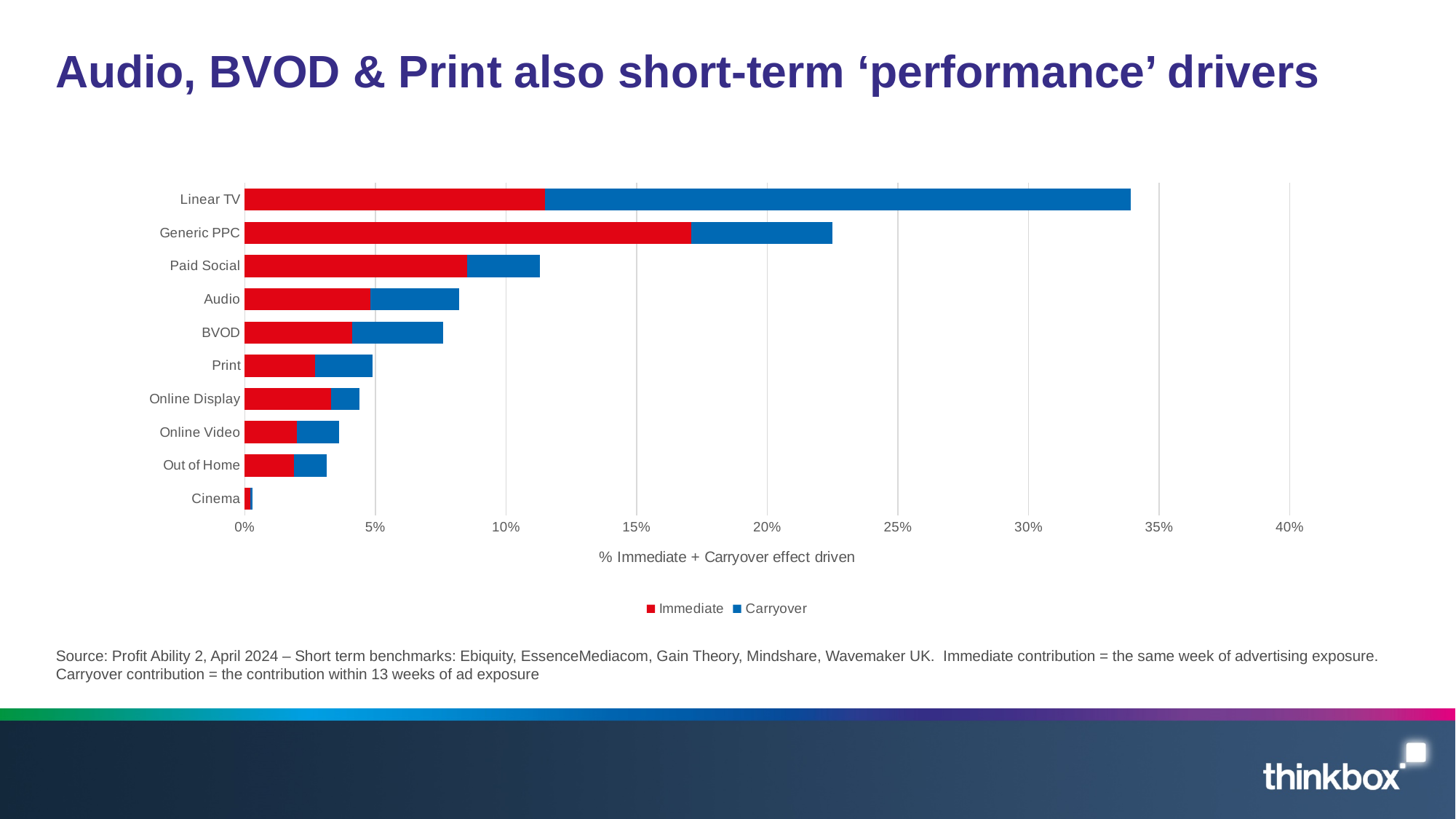
Which is larger: the Immediate segment for Generic PPC or the Immediate segment for Linear TV? Generic PPC Which channel has the shortest total bar? Cinema Is the total bar for Linear TV greater or less than 30%? greater Which channel has the longest total bar (Immediate + Carryover)? Linear TV What colour represents the Immediate series in the chart? Red Is the total bar for Generic PPC greater or less than 20%? greater Is the total bar for Audio greater or less than 10%? less What kind of chart is shown on the slide? Stacked bar chart How many series does the legend list? 2 Which is larger: the Carryover segment for Linear TV or the Carryover segment for Generic PPC? Linear TV How many media channels are listed on the chart? 10